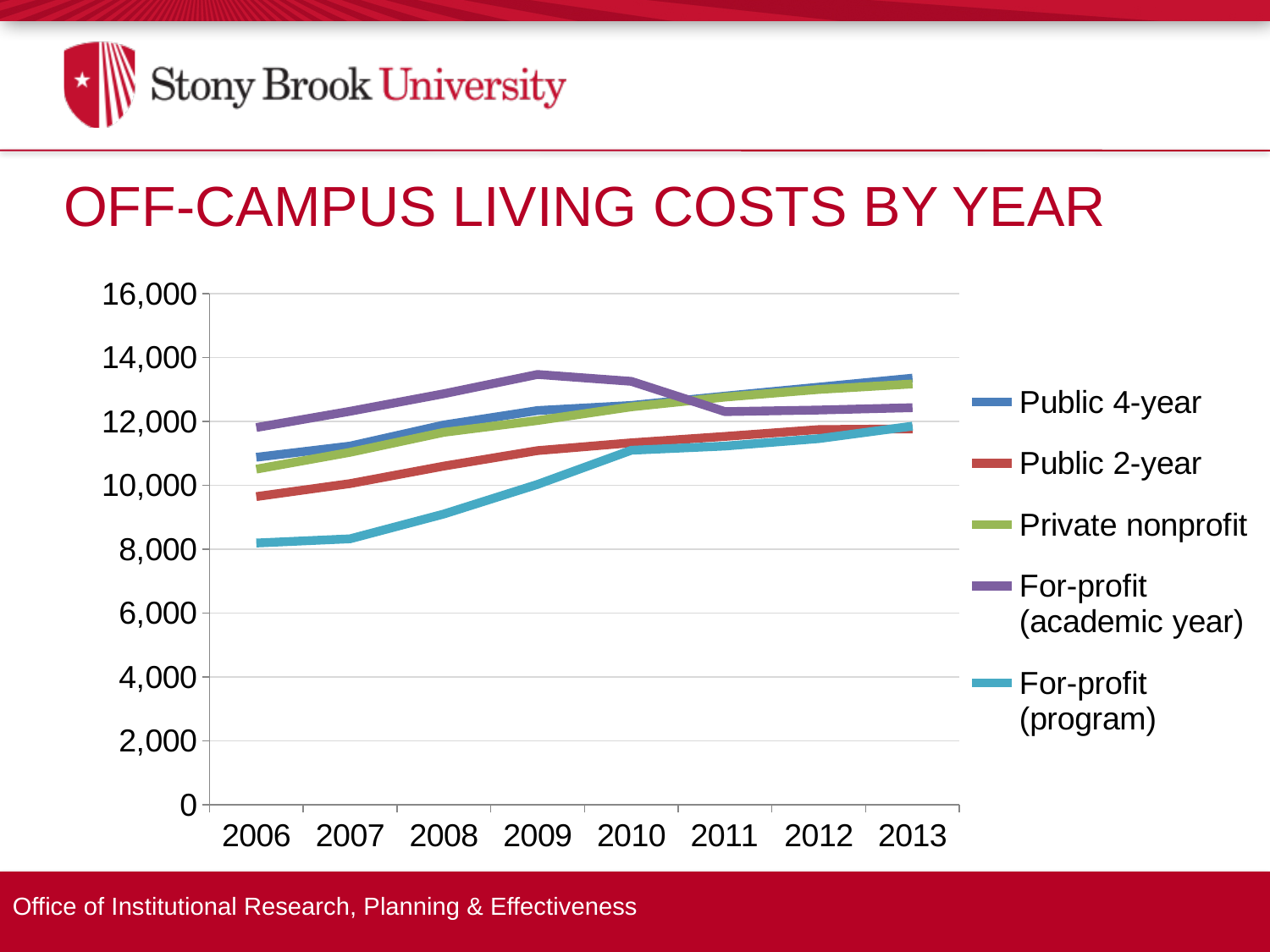
Which series has the highest value in 2006? For-profit (academic year) How many years are shown on the x axis? 8 Which series has the lowest value in 2006? For-profit (program) In 2013, which is larger: Public 4-year or For-profit (program)? Public 4-year What kind of chart is shown on the slide? line chart Is the value for Public 2-year in 2006 greater or less than 10,000? less Do the values for For-profit (program) rise or fall from 2006 to 2013? rise How many series does the legend list? 5 Is the value for For-profit (academic year) in 2009 greater or less than 12,000? greater Do the values for For-profit (academic year) rise or fall from 2009 to 2011? fall Is the value for For-profit (program) in 2006 greater or less than 10,000? less What is the title of the chart? OFF-CAMPUS LIVING COSTS BY YEAR